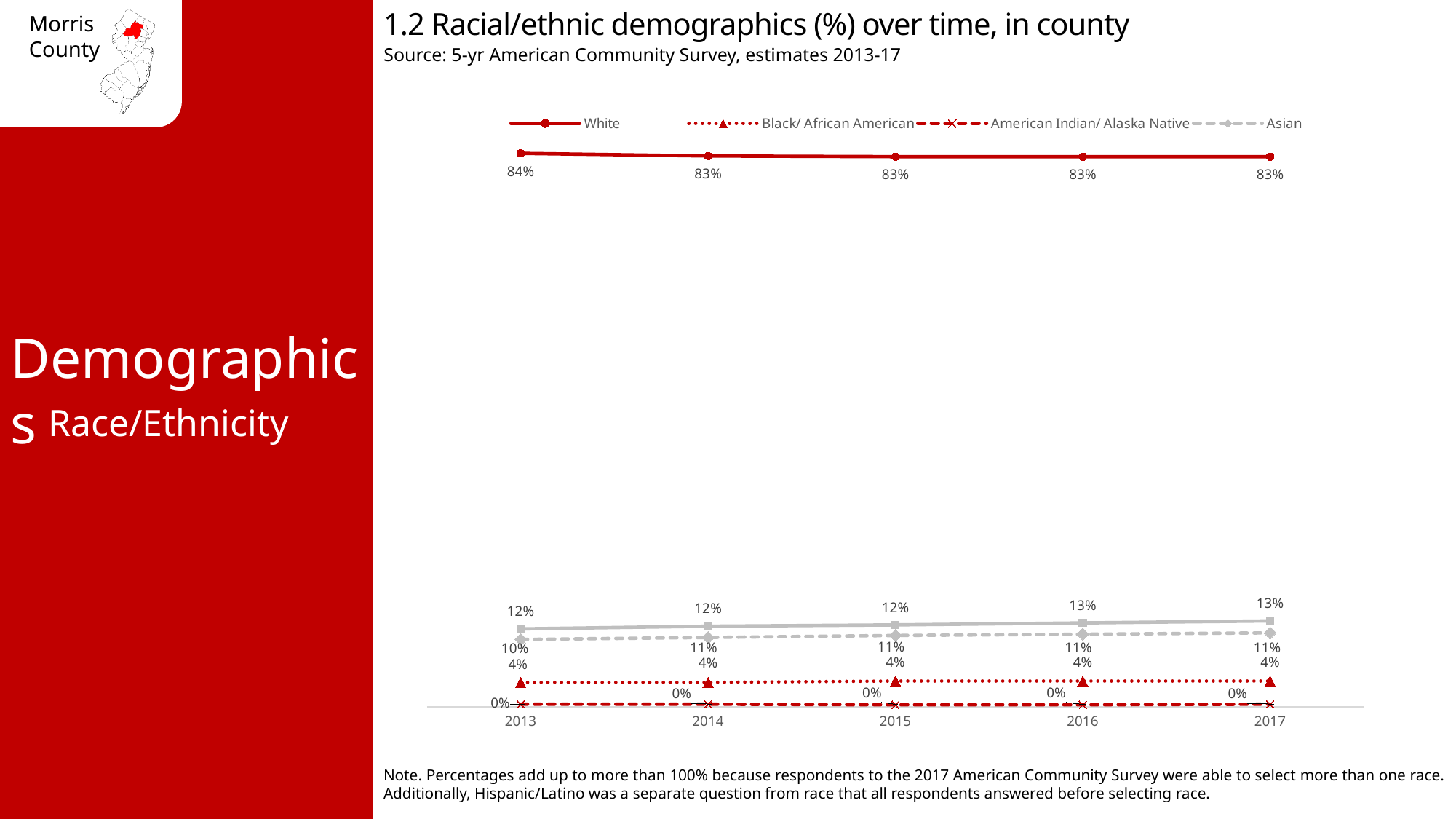
What is the value for Asian in 2013? 10% What kind of chart is shown on the slide? Line chart What is the value for Black/ African American in 2015? 4% What is the value for White in 2017? 83% How many years are shown on the x axis? 5 What is the value for American Indian/ Alaska Native in 2016? 0% What is the value for White in 2013? 84% Which series has the lowest value in 2013? American Indian/ Alaska Native Which series has the highest value in 2017? White What is the value for Asian in 2017? 11% What is the difference between the White and Asian values in 2013? 74 percentage points In 2017, which is larger: the Asian value or the Black/ African American value? Asian